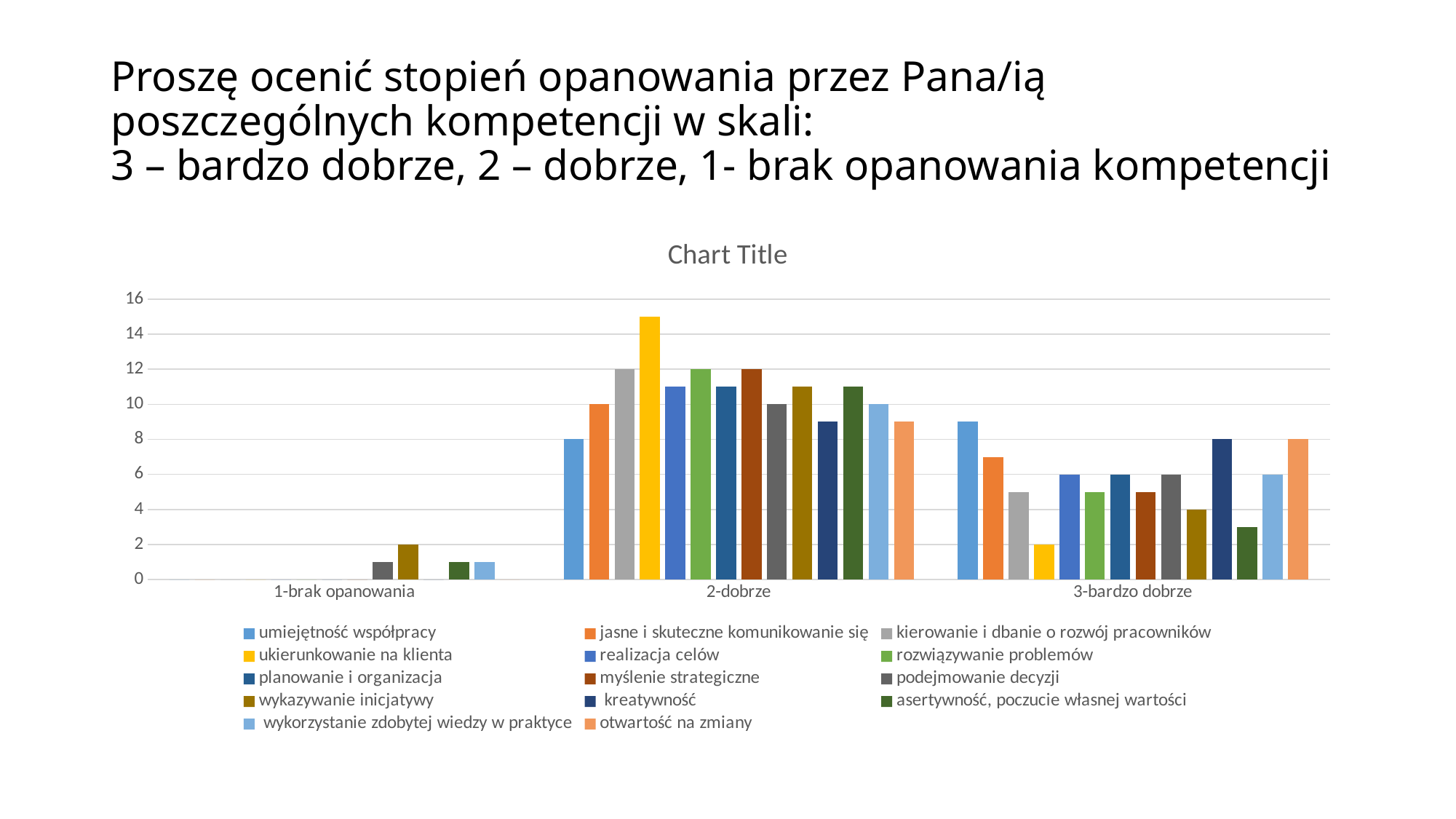
How many categories are shown on the x axis? 3 What kind of chart is shown on the slide? bar chart What is the value for wykazywanie inicjatywy in the 1-brak opanowania category? 2 Is the value for asertywność, poczucie własnej wartości in the 3-bardzo dobrze category greater or less than 4? less Is the value for ukierunkowanie na klienta in the 2-dobrze category greater or less than 14? greater What is the value for umiejętność współpracy in the 2-dobrze category? 8 What is the value for otwartość na zmiany in the 3-bardzo dobrze category? 8 Which series has the highest value in the 2-dobrze category? ukierunkowanie na klienta What is the value for kierowanie i dbanie o rozwój pracowników in the 2-dobrze category? 12 In the 2-dobrze category, what is the difference between kierowanie i dbanie o rozwój pracowników and umiejętność współpracy? 4 How many series does the legend list? 14 Which series has the lowest value in the 3-bardzo dobrze category? ukierunkowanie na klienta